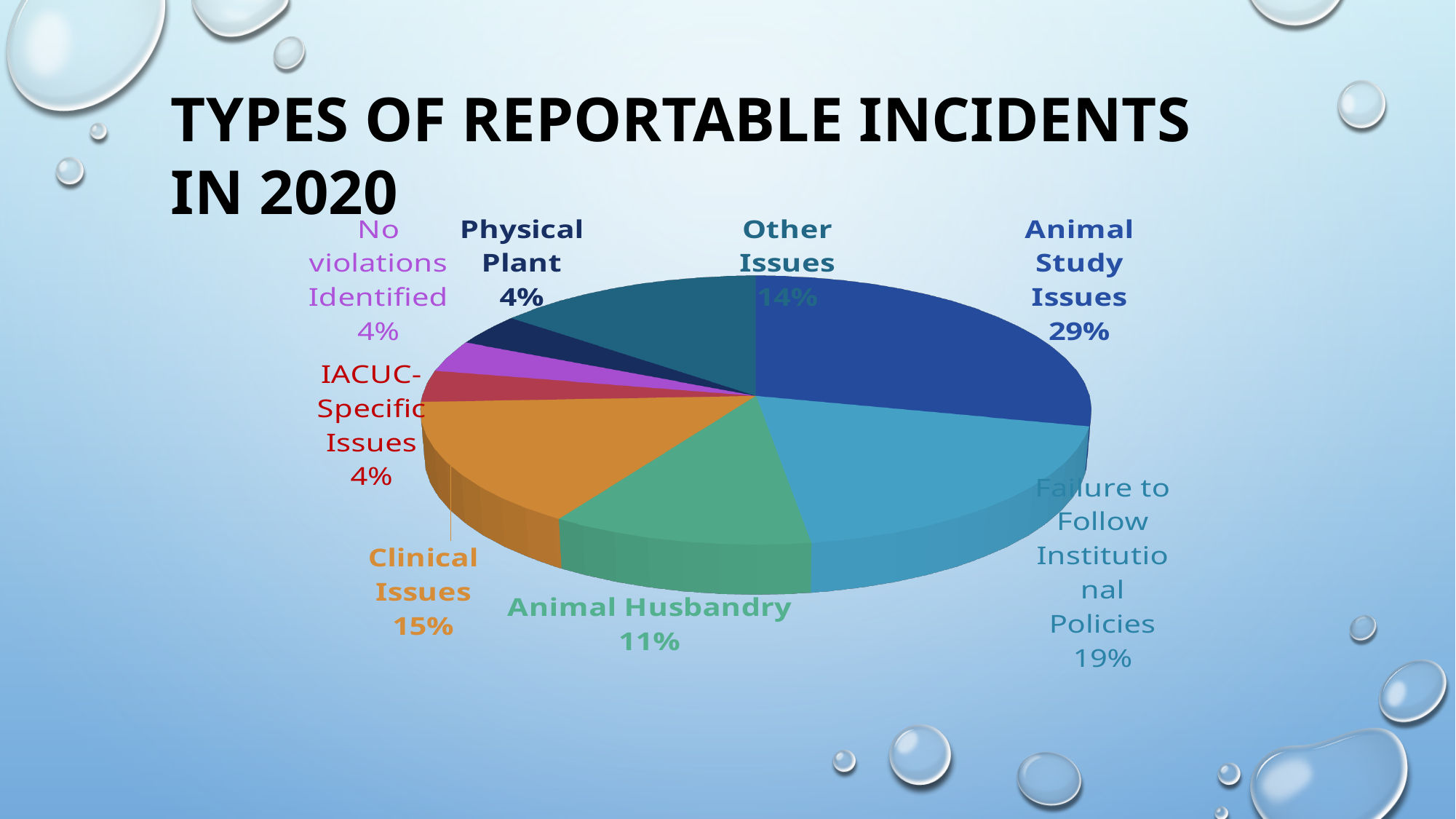
Which category has the largest share of reportable incidents? Animal Study Issues What percentage is shown for Other Issues? 14% How many categories are shown in the pie chart? 8 What share of the pie is Failure to Follow Institutional Policies? 19% What percentage is shown for Physical Plant? 4% What kind of chart is shown on the slide? Pie chart What is the title of the chart on the slide? Types of Reportable Incidents in 2020 What is the difference in percentage points between Animal Study Issues and Failure to Follow Institutional Policies? 10 What percentage of reportable incidents were Clinical Issues? 15% Which is larger, the share for Clinical Issues or the share for Other Issues? Clinical Issues What percentage of reportable incidents were Animal Study Issues? 29% What percentage is shown for Animal Husbandry? 11%